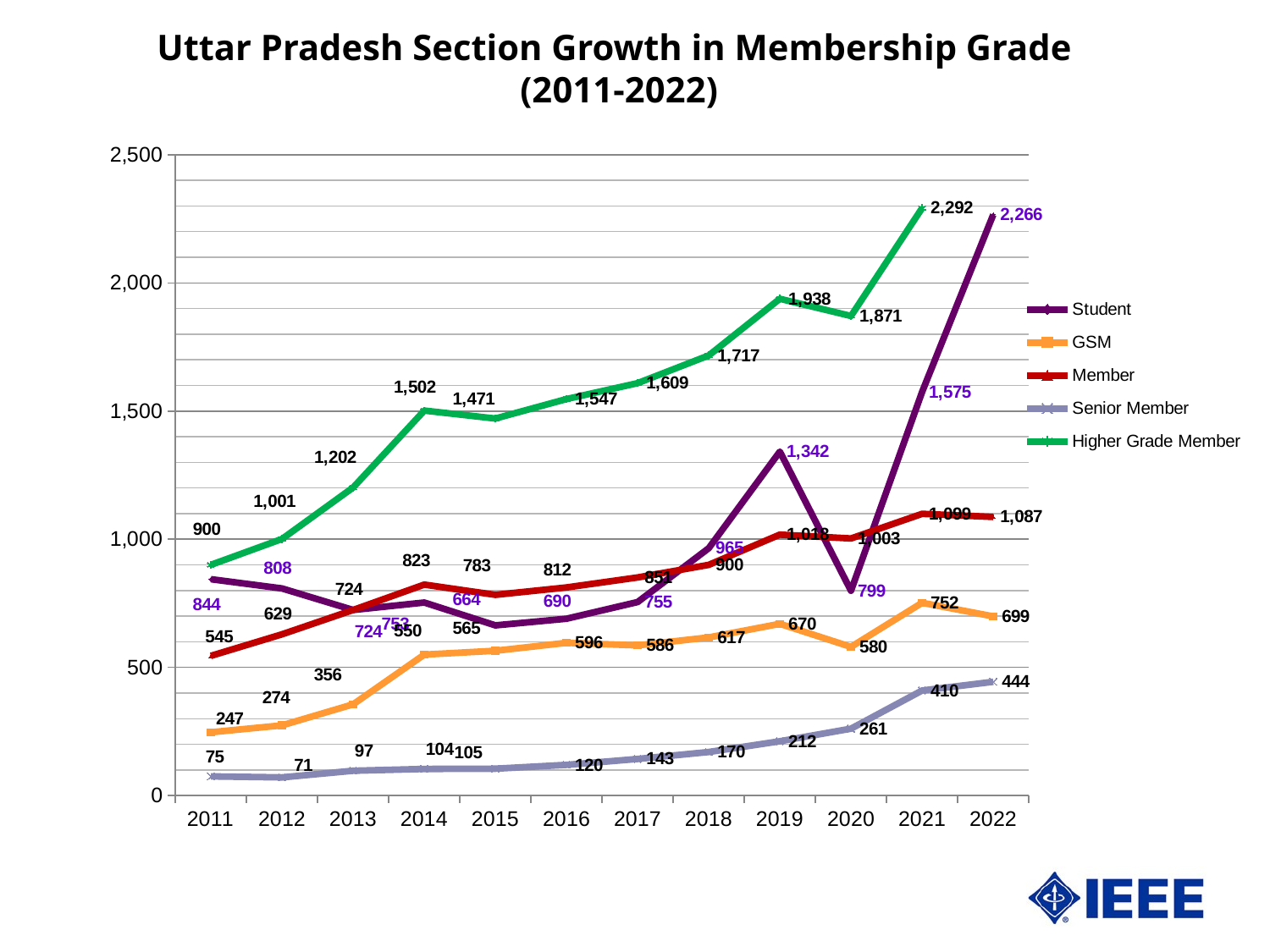
What is the Senior Member value in 2011? 75 What is the Student value in 2019? 1,342 What is the GSM value in 2014? 550 Which is larger in 2021, the GSM value or the Member value? Member In which year is the Senior Member value lowest? 2012 What type of chart is shown on the slide? Line chart How many series does the legend list? 5 In which year is the GSM value highest? 2021 What is the title of the chart? Uttar Pradesh Section Growth in Membership Grade (2011-2022) What is the Higher Grade Member value in 2021? 2,292 How many years are shown on the x axis? 12 What is the difference between the Member value in 2022 and in 2011? 542